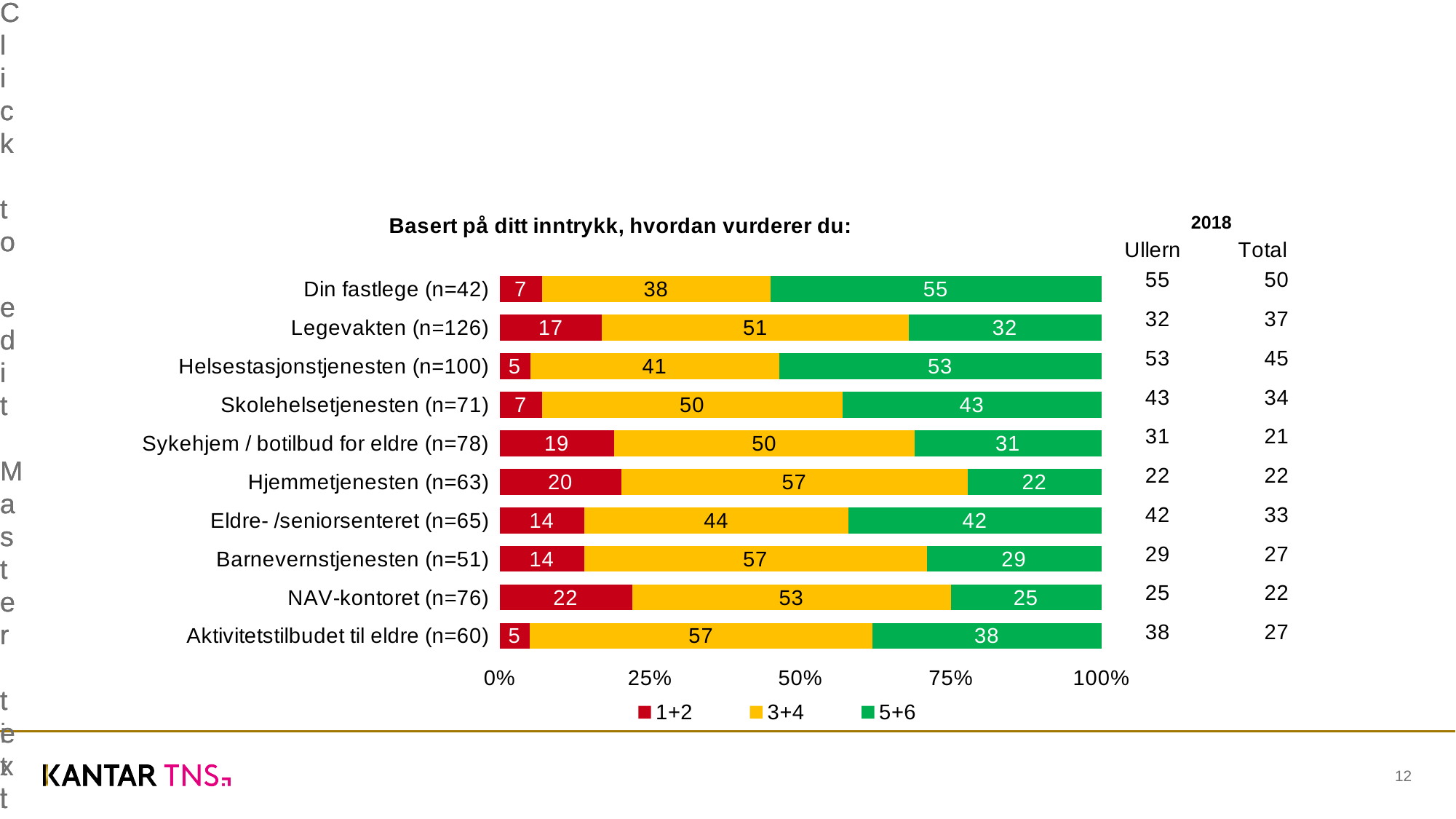
What is the 5+6 value for Din fastlege (n=42)? 55 How many series does the legend list? 3 What kind of chart is shown on the slide? Stacked bar chart What is the difference between the 5+6 values for Helsestasjonstjenesten (n=100) and Legevakten (n=126)? 21 Which category has the lowest 5+6 value? Hjemmetjenesten (n=63) Which is larger, the 3+4 value for Legevakten (n=126) or the 3+4 value for Eldre- /seniorsenteret (n=65)? Legevakten (n=126) What is the 1+2 value for NAV-kontoret (n=76)? 22 Which category has the highest 1+2 value? NAV-kontoret (n=76) What is the 3+4 value for Hjemmetjenesten (n=63)? 57 Which category has the highest 5+6 value? Din fastlege (n=42) How many categories are shown on the chart? 10 What is the title of the chart? Basert på ditt inntrykk, hvordan vurderer du: